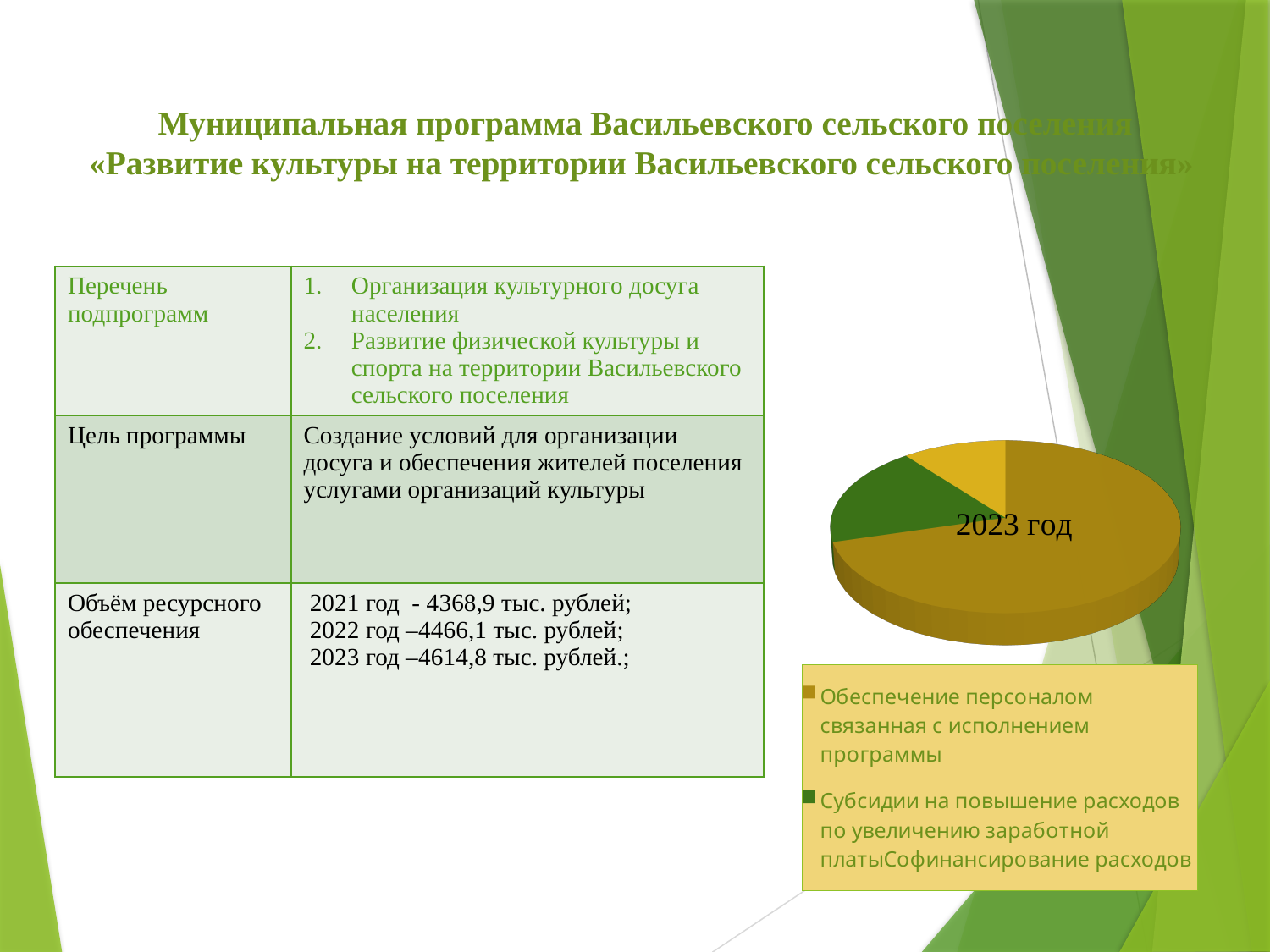
What is the title of the pie chart? 2023 год Which legend category has the largest slice in the pie chart? Обеспечение персоналом связанная с исполнением программы What kind of chart is shown on the slide? pie chart Which slice is larger in the pie chart: "Обеспечение персоналом связанная с исполнением программы" or "Субсидии на повышение расходов по увеличению заработной платыСофинансирование расходов"? Обеспечение персоналом связанная с исполнением программы How many entries does the legend of the pie chart list? 2 What colour is the slice for "Обеспечение персоналом связанная с исполнением программы" in the pie chart? gold How many slices does the pie chart have? 3 Does the slice for "Обеспечение персоналом связанная с исполнением программы" take up more or less than half of the pie chart? more